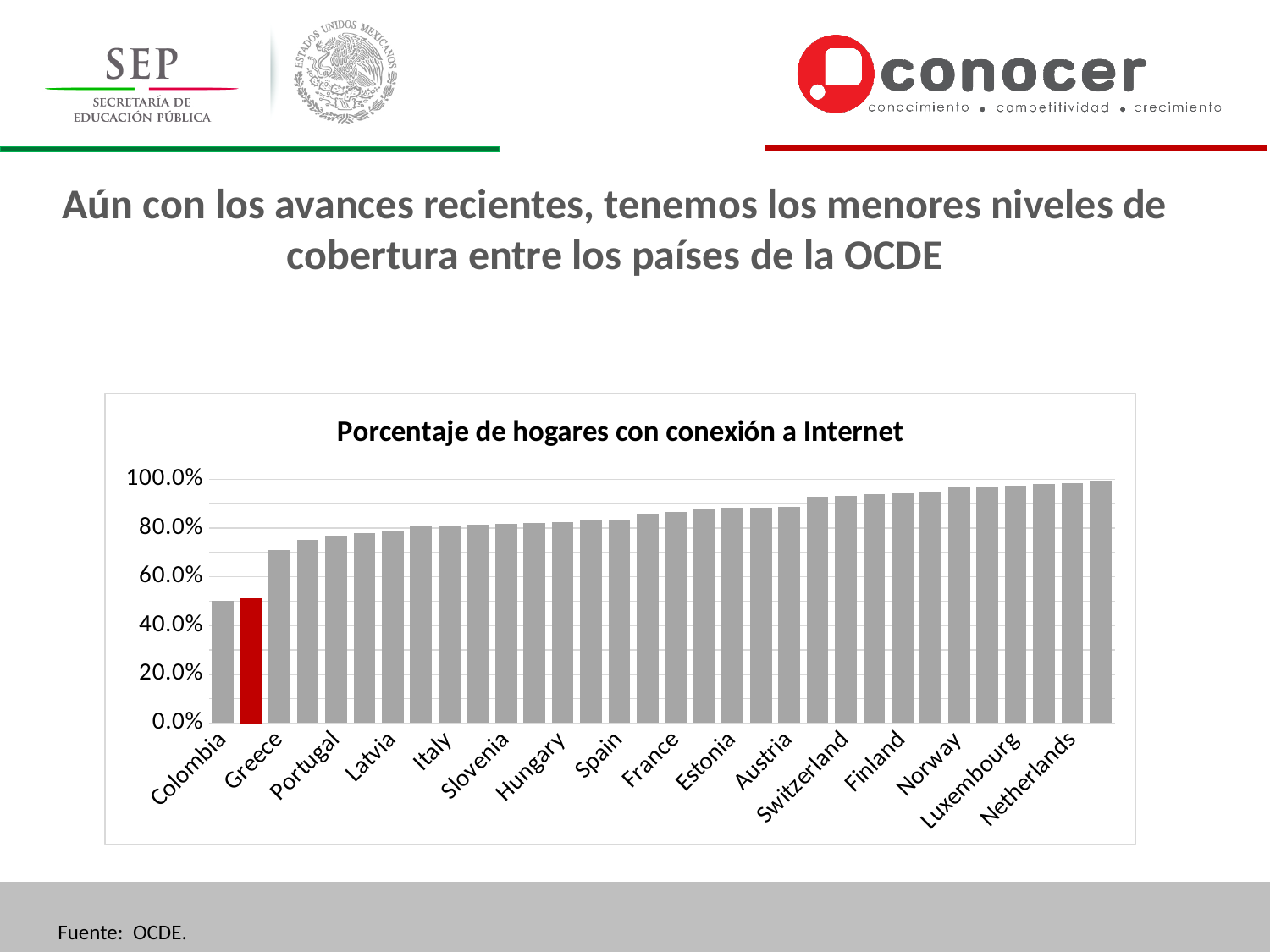
Which labelled country has the highest percentage of households with an Internet connection? Netherlands Which labelled country has the lowest percentage of households with an Internet connection? Colombia Is the value for Colombia greater or less than 60.0%? less What kind of chart is shown on the slide? bar chart What is the title of the chart? Porcentaje de hogares con conexión a Internet Do the values rise or fall moving from left to right along the x axis? rise Which has a higher value, Greece or Spain? Spain Is the value for Switzerland greater or less than 80.0%? greater Is the value for Netherlands greater or less than 80.0%? greater What colour is the second bar from the left? red